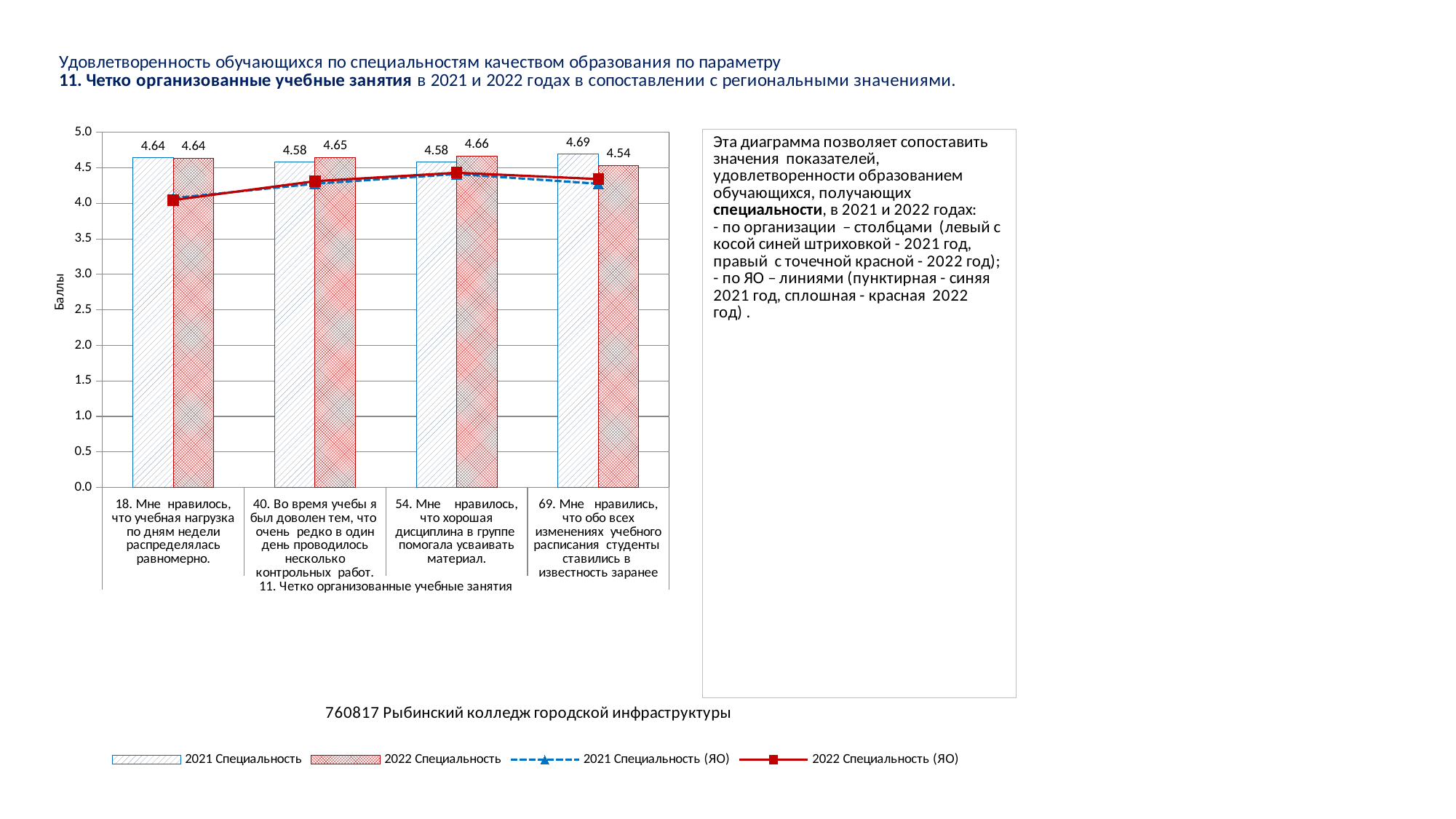
What is the label of the vertical axis? Баллы What is the 2021 Специальность value for category 18 (Мне нравилось, что учебная нагрузка по дням недели распределялась равномерно)? 4.64 How many categories are shown on the x axis? 4 Is the 2021 Специальность (ЯО) line value for category 18 greater or less than 4.5? less What is the 2022 Специальность value for category 54 (Мне нравилось, что хорошая дисциплина в группе помогала усваивать материал)? 4.66 How many series does the legend list? 4 For category 54, which is larger: the 2021 Специальность value or the 2022 Специальность value? 2022 Специальность What is the 2022 Специальность value for category 69 (Мне нравились, что обо всех изменениях учебного расписания студенты ставились в известность заранее)? 4.54 Which category has the highest 2021 Специальность value? 69. Мне нравились, что обо всех изменениях учебного расписания студенты ставились в известность заранее What is the 2021 Специальность value for category 40 (Во время учебы я был доволен тем, что очень редко в один день проводилось несколько контрольных работ)? 4.58 Which category has the lowest 2022 Специальность value? 69. Мне нравились, что обо всех изменениях учебного расписания студенты ставились в известность заранее What is the difference between the 2021 and 2022 Специальность values for category 69? 0.15